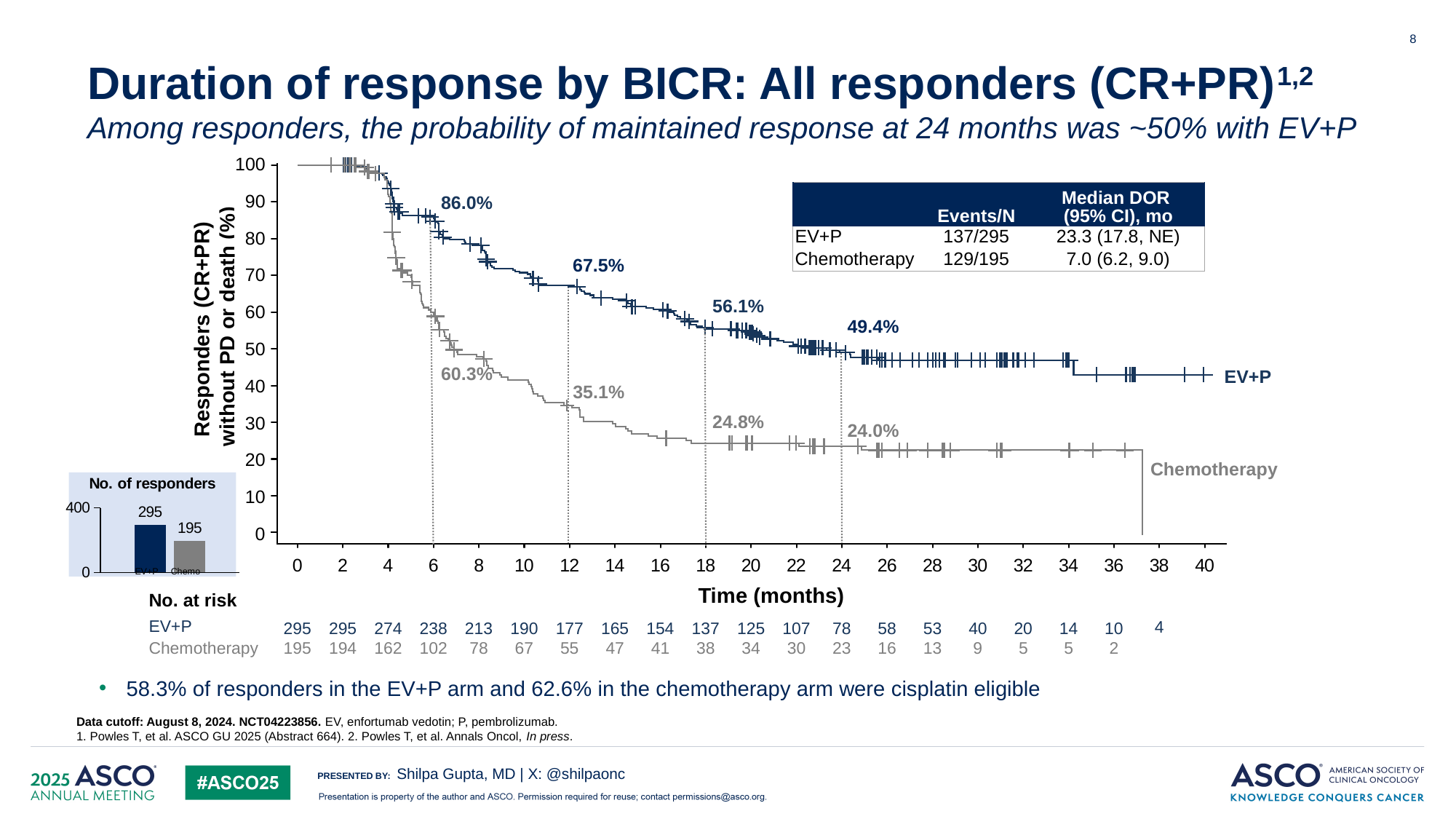
In the duration of response curve chart, what is the labelled value for EV+P at 12 months? 67.5% In the duration of response curve chart, what is the labelled value for EV+P at 24 months? 49.4% In the 'No. of responders' bar chart, what is the value for EV+P? 295 In the 'No. of responders' bar chart, what is the value for Chemo? 195 In the 'No. of responders' bar chart, what is the difference between the EV+P and Chemo bars? 100 What is the x-axis label of the duration of response curve chart? Time (months) In the duration of response curve chart, what is the labelled value for Chemotherapy at 24 months? 24.0% What kind of chart is the small 'No. of responders' chart? bar chart In the duration of response curve chart, what is the difference between the labelled EV+P and Chemotherapy values at 6 months? 25.7 percentage points In the duration of response curve chart, which curve is higher at 18 months, EV+P or Chemotherapy? EV+P In the 'No. of responders' bar chart, which arm has the higher number of responders? EV+P In the duration of response curve chart, does the EV+P curve rise or fall as time increases? fall